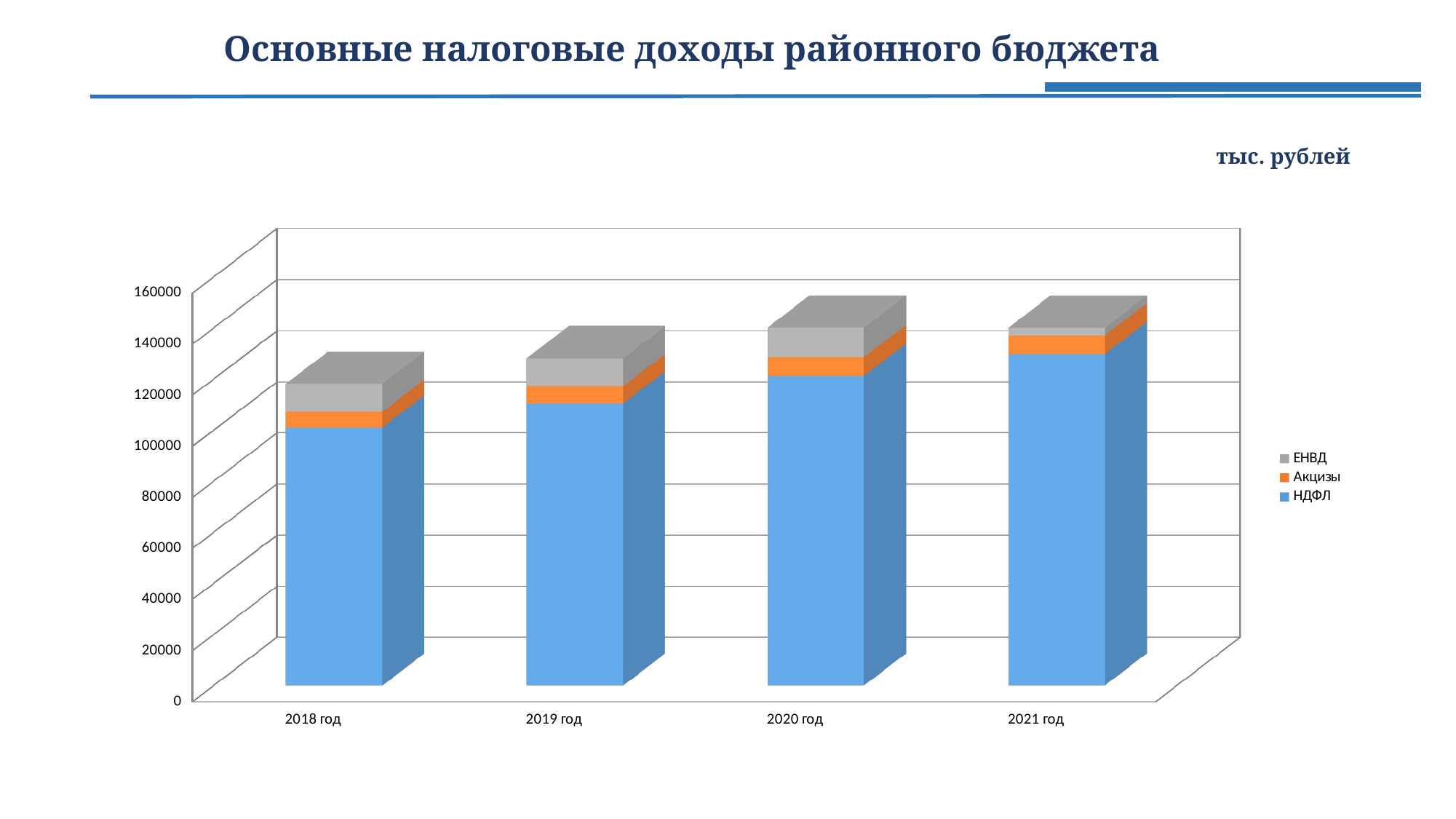
Which year has the smallest ЕНВД segment? 2021 год Is the НДФЛ value for 2021 год greater or less than 120000? greater What kind of chart is shown on the slide? bar chart Is the НДФЛ value for 2018 год greater or less than 80000? greater Does the НДФЛ value rise or fall from 2018 год to 2021 год? rise How many years are shown on the x axis of the chart? 4 Which is larger, the total stacked bar for 2018 год or for 2021 год? 2021 год In what units are the values on the chart given? тыс. рублей Which year has the lowest total stacked bar? 2018 год How many series does the chart legend list? 3 What is the title of the chart on the slide? Основные налоговые доходы районного бюджета